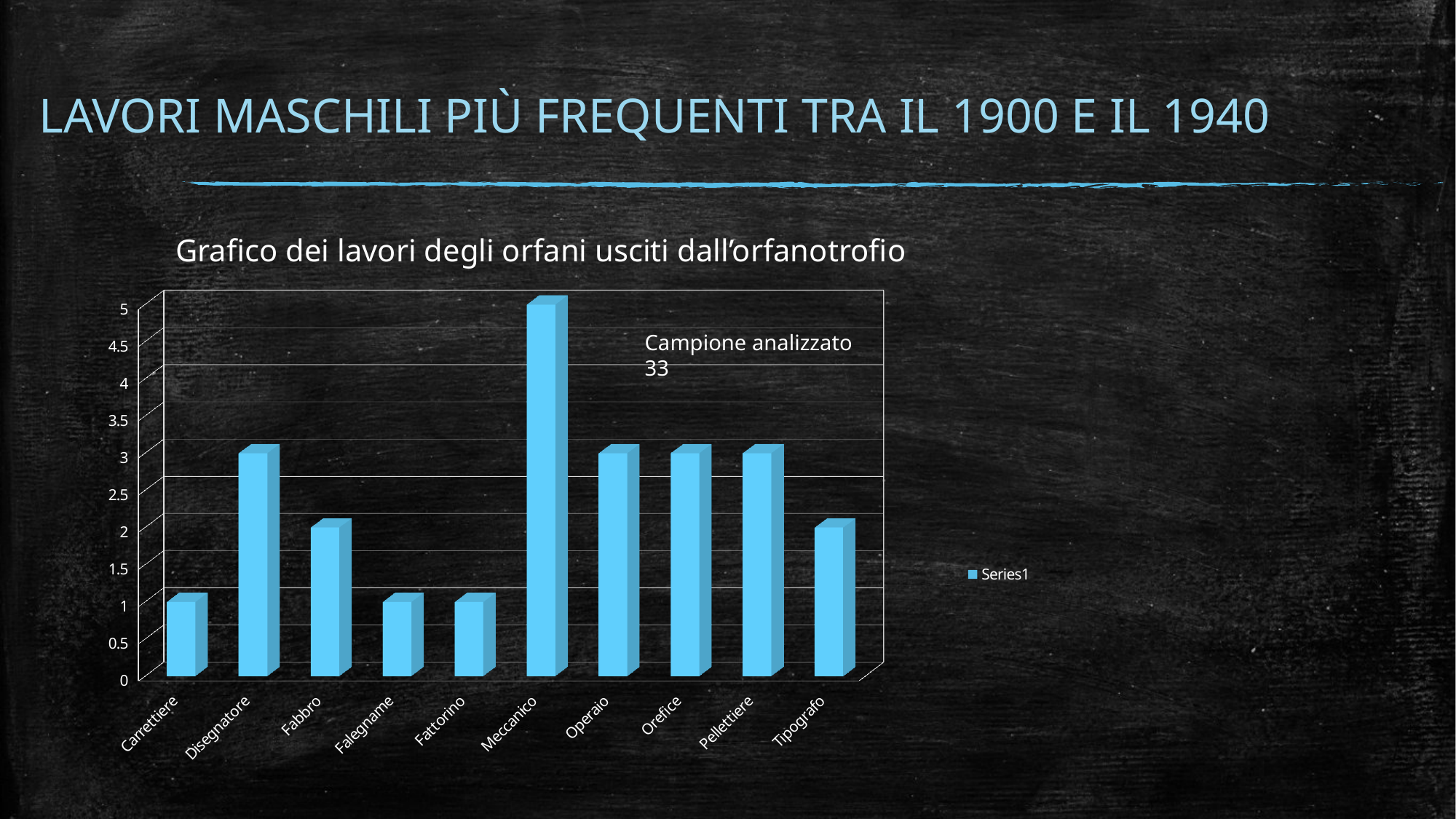
Is the value for Pellettiere greater or less than 2? greater What is the value for Disegnatore? 3 What is the difference between the values for Meccanico and Tipografo? 3 What kind of chart is shown on the slide? bar chart Which job category has the highest bar in the chart? Meccanico What is the value for Fabbro? 2 What is the value for Meccanico? 5 How many job categories are shown on the x axis of the chart? 10 What is the title of the chart? Grafico dei lavori degli orfani usciti dall'orfanotrofio What is the value for Carrettiere? 1 Which is larger, the value for Orefice or the value for Falegname? Orefice How many series does the legend list? 1